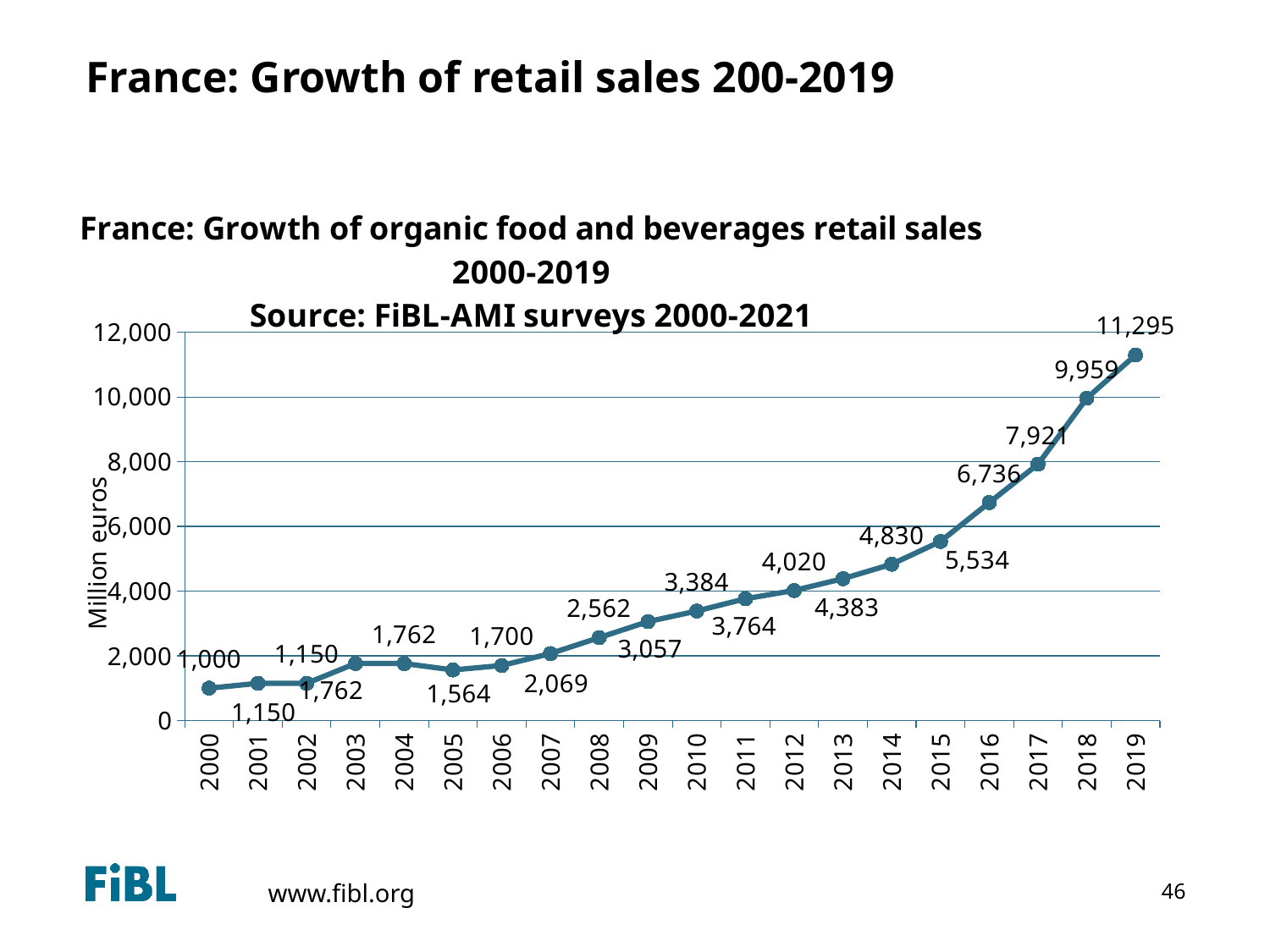
What kind of chart is shown? line chart What is the difference between the values for 2019 and 2018? 1,336 Which is larger, the value for 2015 or the value for 2014? 2015 Which year has the highest value? 2019 Is the value for 2016 greater or less than 6,000? greater What is the value for 2019? 11,295 Which year has the lowest value? 2000 How many years are plotted on the chart? 20 Do the values generally rise or fall from 2000 to 2019? rise What is the value for 2000? 1,000 What is the value for 2010? 3,384 What is the label on the vertical axis? Million euros